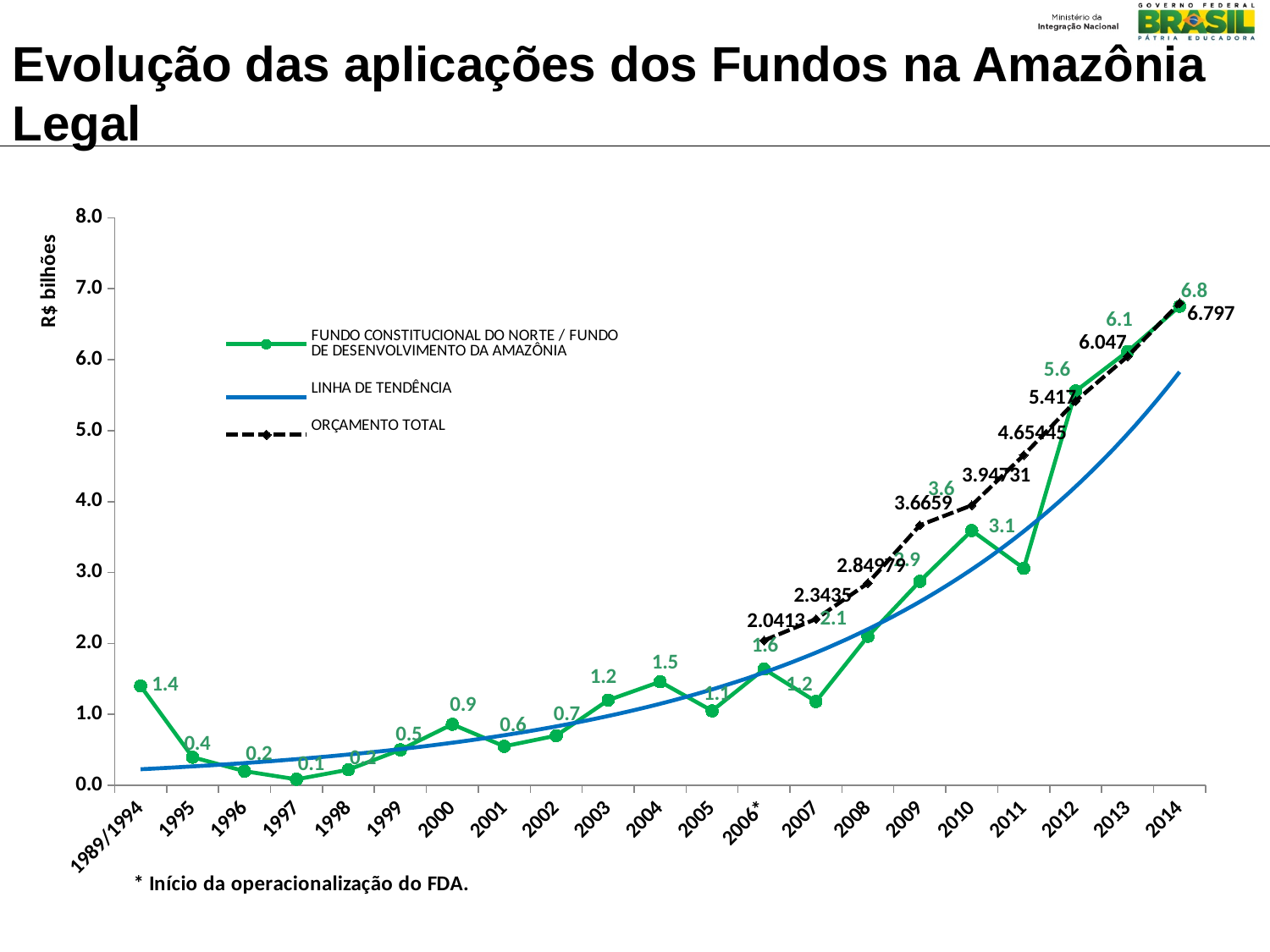
What is the ORÇAMENTO TOTAL value for 2012? 5.412 How many series does the chart legend list? 3 Is the LINHA DE TENDÊNCIA value in 2014 greater or less than 5.0? greater By how much did the FUNDO CONSTITUCIONAL DO NORTE / FUNDO DE DESENVOLVIMENTO DA AMAZÔNIA value increase from 2013 to 2014? 0.7 What is the ORÇAMENTO TOTAL value for 2014? 6.797 In which year does the FUNDO CONSTITUCIONAL DO NORTE / FUNDO DE DESENVOLVIMENTO DA AMAZÔNIA series have its lowest value? 1997 In which year does the FUNDO CONSTITUCIONAL DO NORTE / FUNDO DE DESENVOLVIMENTO DA AMAZÔNIA series reach its highest value? 2014 What is the value of the FUNDO CONSTITUCIONAL DO NORTE / FUNDO DE DESENVOLVIMENTO DA AMAZÔNIA series in 2004? 1.5 Which year has the larger FUNDO CONSTITUCIONAL DO NORTE / FUNDO DE DESENVOLVIMENTO DA AMAZÔNIA value, 2010 or 2011? 2010 How many periods are shown on the x axis of the chart? 21 What is the value of the FUNDO CONSTITUCIONAL DO NORTE / FUNDO DE DESENVOLVIMENTO DA AMAZÔNIA series in 2010? 3.6 What type of chart is shown on the slide? line chart